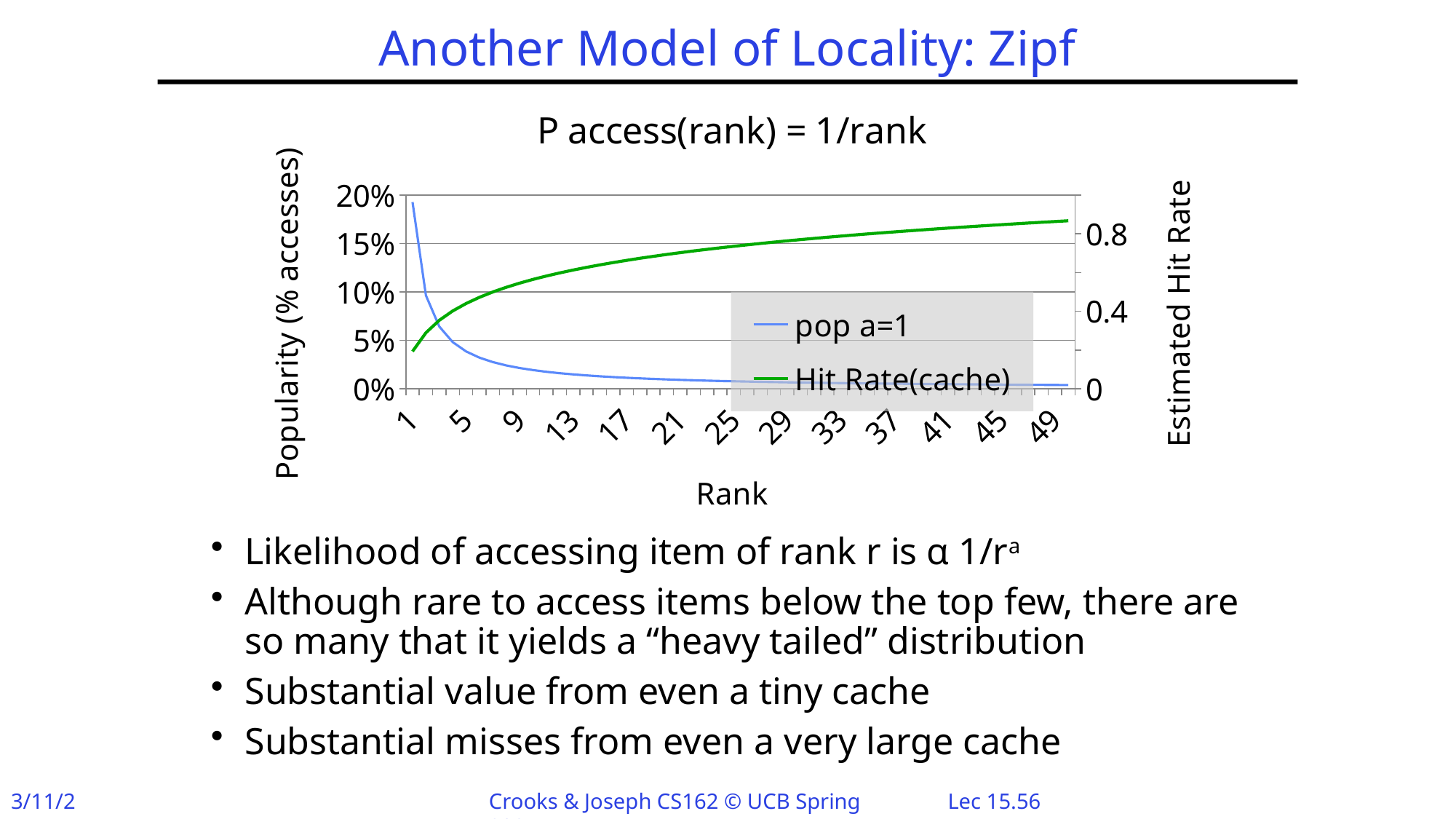
What is the title of the chart? P access(rank) = 1/rank Does the pop a=1 series rise or fall as rank increases along the x axis? fall Which series has the higher value at rank 1 on its own axis scale: pop a=1 (left axis, 0%-20%) or Hit Rate(cache) (right axis, 0-0.8)? pop a=1 What are the two series named in the legend? pop a=1 and Hit Rate(cache) Is the value of Hit Rate(cache) at rank 49 greater or less than 0.8? greater Is the value of Hit Rate(cache) at rank 25 greater or less than 0.4? greater How many series does the chart's legend list? 2 Is the value of pop a=1 at rank 1 greater or less than 15%? greater What kind of chart is shown on the slide? line chart Does the Hit Rate(cache) series rise or fall as rank increases along the x axis? rise